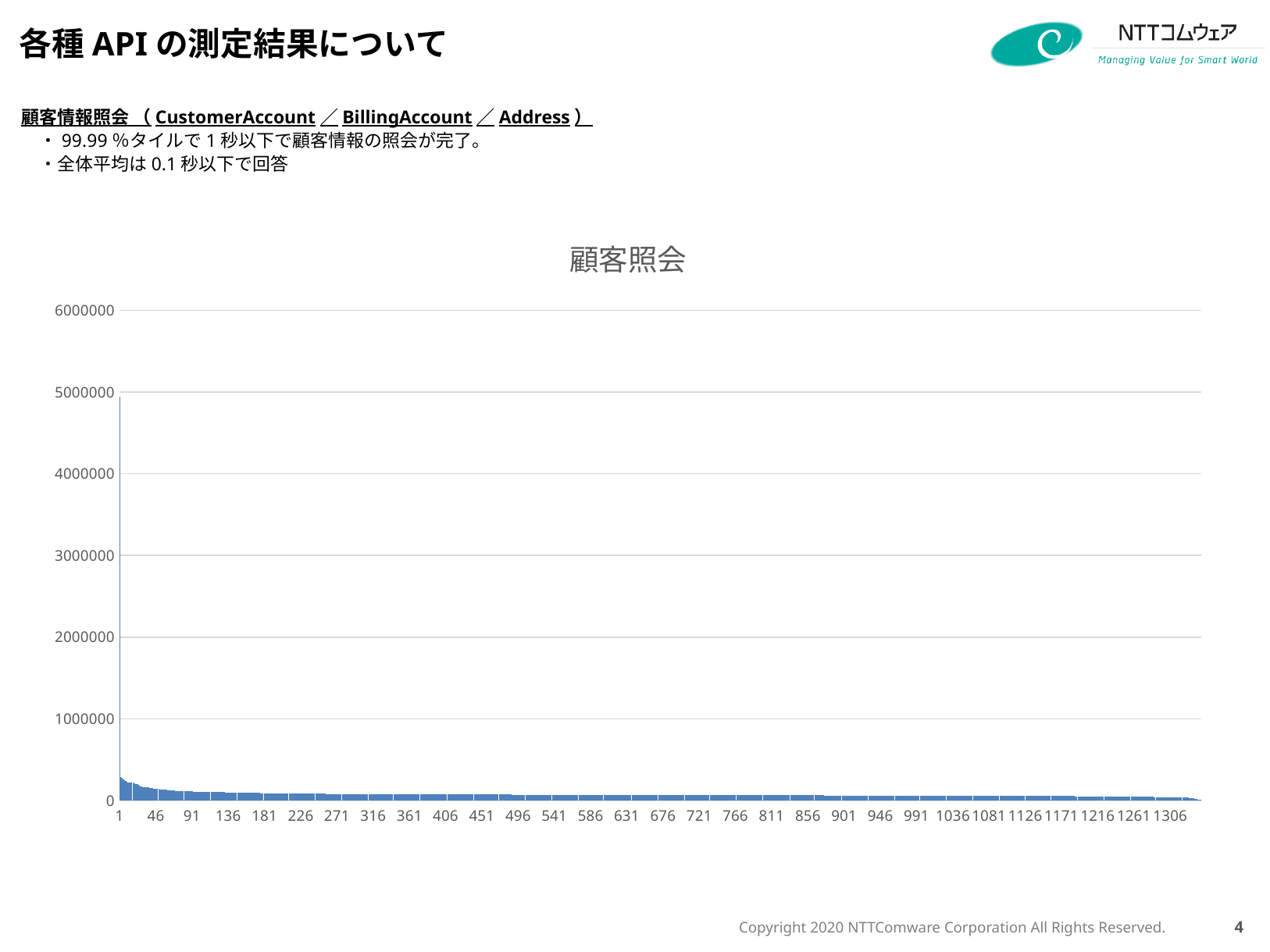
Which category has the highest value in the 顧客照会 chart? 1 What is the title of the chart? 顧客照会 Which is larger in the 顧客照会 chart, the value for category 46 or the value for category 901? 46 Is the value for category 1306 in the 顧客照会 chart greater or less than 1000000? less Is the value for category 1 in the 顧客照会 chart greater or less than 1000000? greater What is the highest tick label shown on the y axis of the 顧客照会 chart? 6000000 Do the values in the 顧客照会 chart rise or fall as you move from left to right along the x axis? fall What kind of chart is shown on the slide? bar chart Which is larger in the 顧客照会 chart, the value for category 1 or the value for category 1306? 1 Is the value for category 46 in the 顧客照会 chart greater or less than 1000000? less